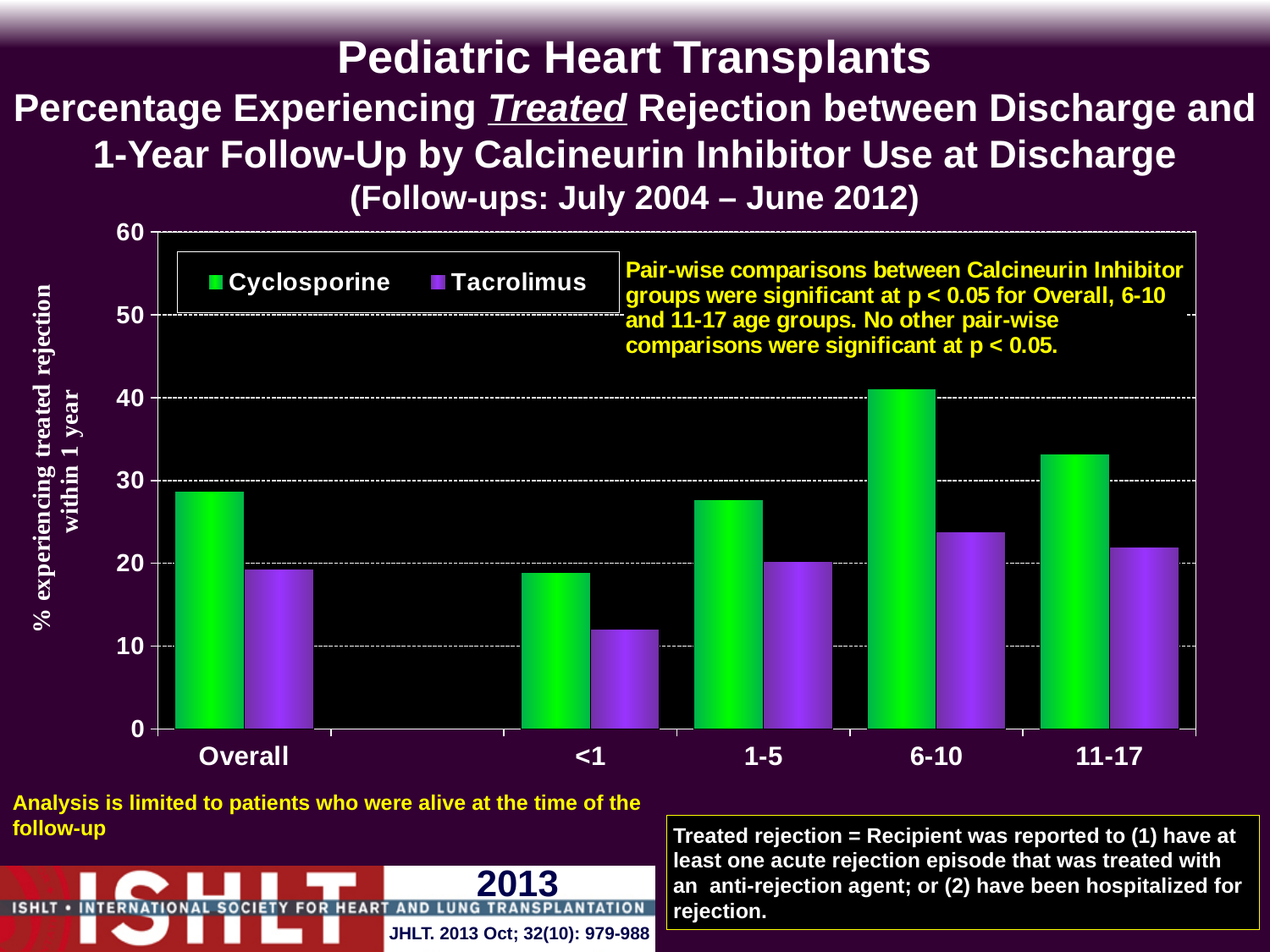
Which age group has the highest Cyclosporine value? 6-10 For the 1-5 age group, which is larger: the Cyclosporine value or the Tacrolimus value? Cyclosporine Is the Cyclosporine value for the 6-10 age group greater or less than 40? greater Is the Tacrolimus value for the <1 age group greater or less than 10? greater Which category has the lowest Tacrolimus value? <1 How many categories are shown on the x axis? 5 Is the Tacrolimus value for the Overall category greater or less than 20? less Which category has the lowest Cyclosporine value? <1 Which colour represents Tacrolimus in the chart? purple How many series does the legend list? 2 What kind of chart is shown on the slide? bar chart